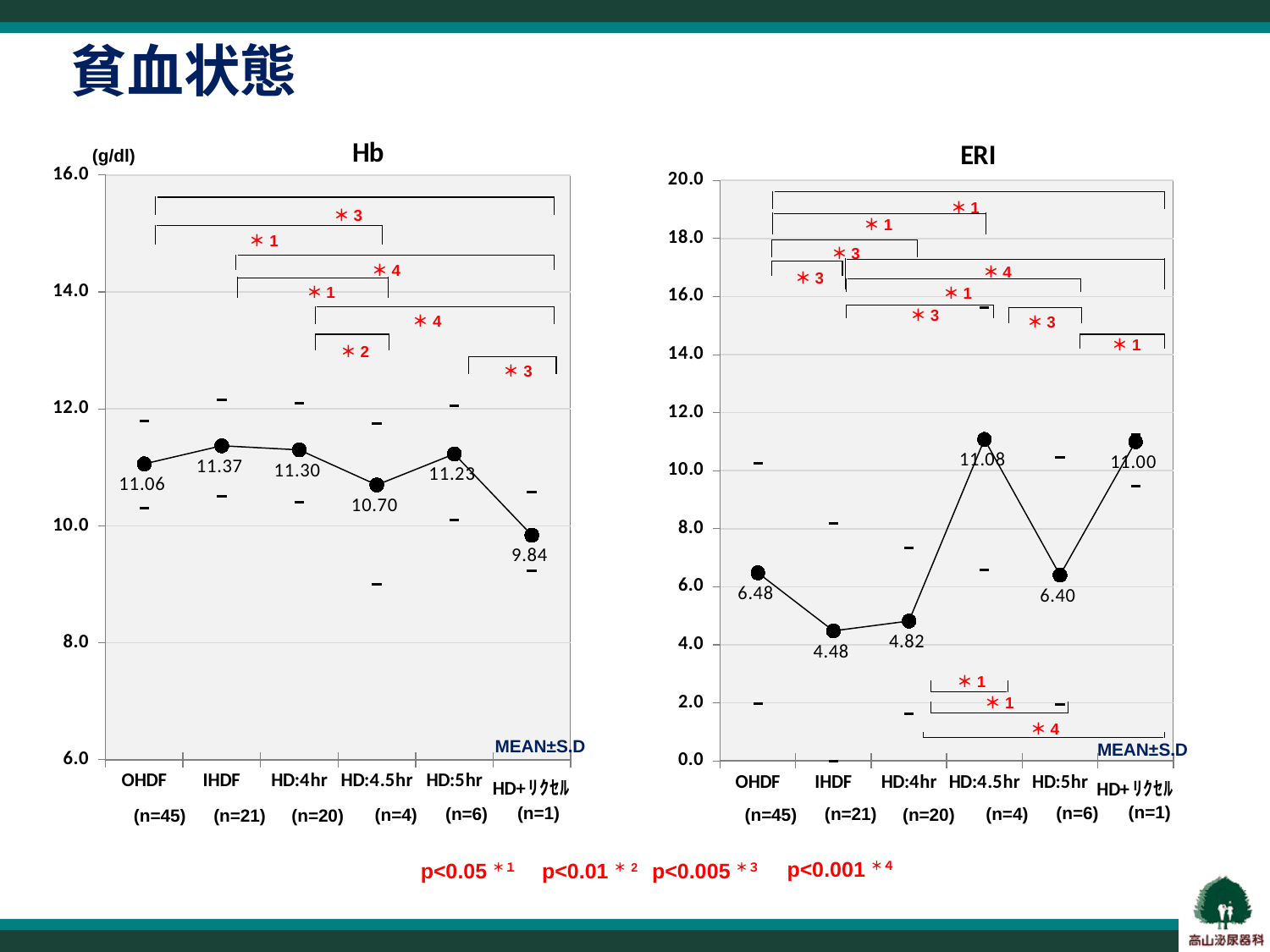
In the Hb chart, which group has the highest mean Hb? IHDF In the Hb chart, which group has the lowest mean Hb? HD+リクセル In the ERI chart, which is larger, the mean ERI for OHDF or for HD:4hr? OHDF How many groups are plotted along the x axis of the ERI chart? 6 In the ERI chart, what is the mean ERI value for HD:5hr? 6.40 In the Hb chart, what is the mean Hb value for HD:4.5hr? 10.70 In the ERI chart, which group has the highest mean ERI? HD:4.5hr In the Hb chart, what is the mean Hb value for OHDF? 11.06 In the ERI chart, which group has the lowest mean ERI? IHDF In the Hb chart, what is the difference between the mean Hb of IHDF and HD+リクセル? 1.53 In the ERI chart, what is the mean ERI value for IHDF? 4.48 What unit is shown on the y axis of the Hb chart? g/dl